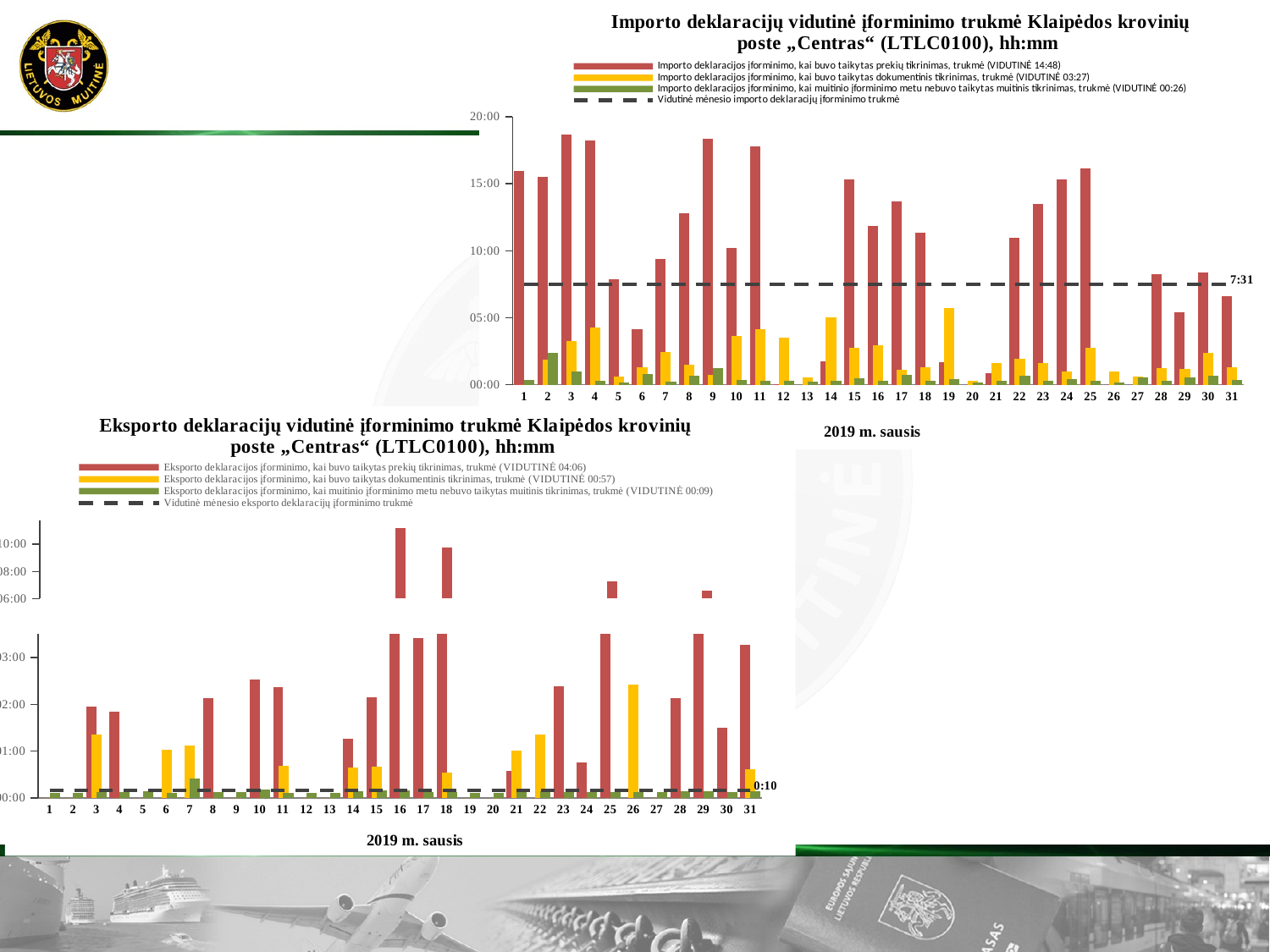
In the export declarations chart (bottom left), on which day is the red bar highest? 16 In the import declarations chart (top right), which red bar is larger: day 4 or day 5? day 4 In the export declarations chart (bottom left), what value is labelled on the dashed monthly average line? 0:10 How many entries does the legend of the import declarations chart (top right) list? 4 In the import declarations chart (top right), is the yellow bar for day 19 greater or less than 05:00? greater In the import declarations chart (top right), is the red bar for day 20 greater or less than 05:00? less In the import declarations chart (top right), is the red bar for day 3 greater or less than 15:00? greater How many days (categories) are shown on the x axis of the export declarations chart (bottom left)? 31 In the export declarations chart (bottom left), which yellow bar is larger: day 3 or day 26? day 26 According to the legend of the import declarations chart (top right), what is the average duration (VIDUTINĖ) for declarations with goods inspection (prekių tikrinimas)? 14:48 In the import declarations chart (top right), what value is labelled on the dashed monthly average line? 7:31 What kind of chart is the import declarations chart at the top right of the slide? bar chart